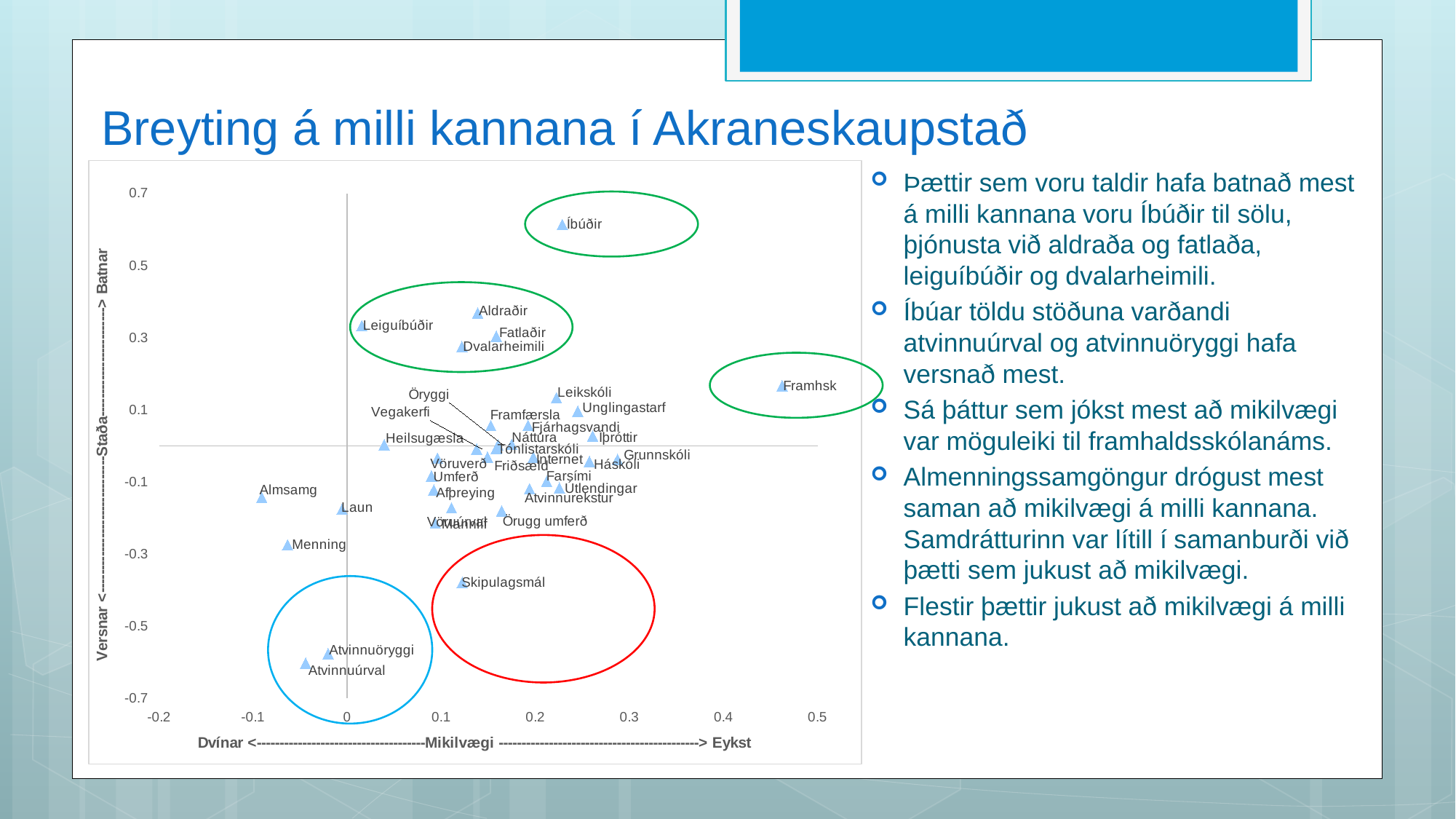
Which point is higher on the vertical axis, Íbúðir or Aldraðir? Íbúðir Is the horizontal-axis value for Framhsk greater or less than 0.4? greater What kind of chart is shown on the slide? scatter chart Which point is highest on the vertical axis? Íbúðir Which point is furthest to the left on the horizontal axis? Almsamg Is the vertical-axis value for Skipulagsmál greater or less than -0.3? less Is the vertical-axis value for Íbúðir greater or less than 0.5? greater How many green ellipses are drawn on the chart? 3 Which point is further right on the horizontal axis, Framhsk or Leikskóli? Framhsk Which point is furthest to the right on the horizontal axis? Framhsk